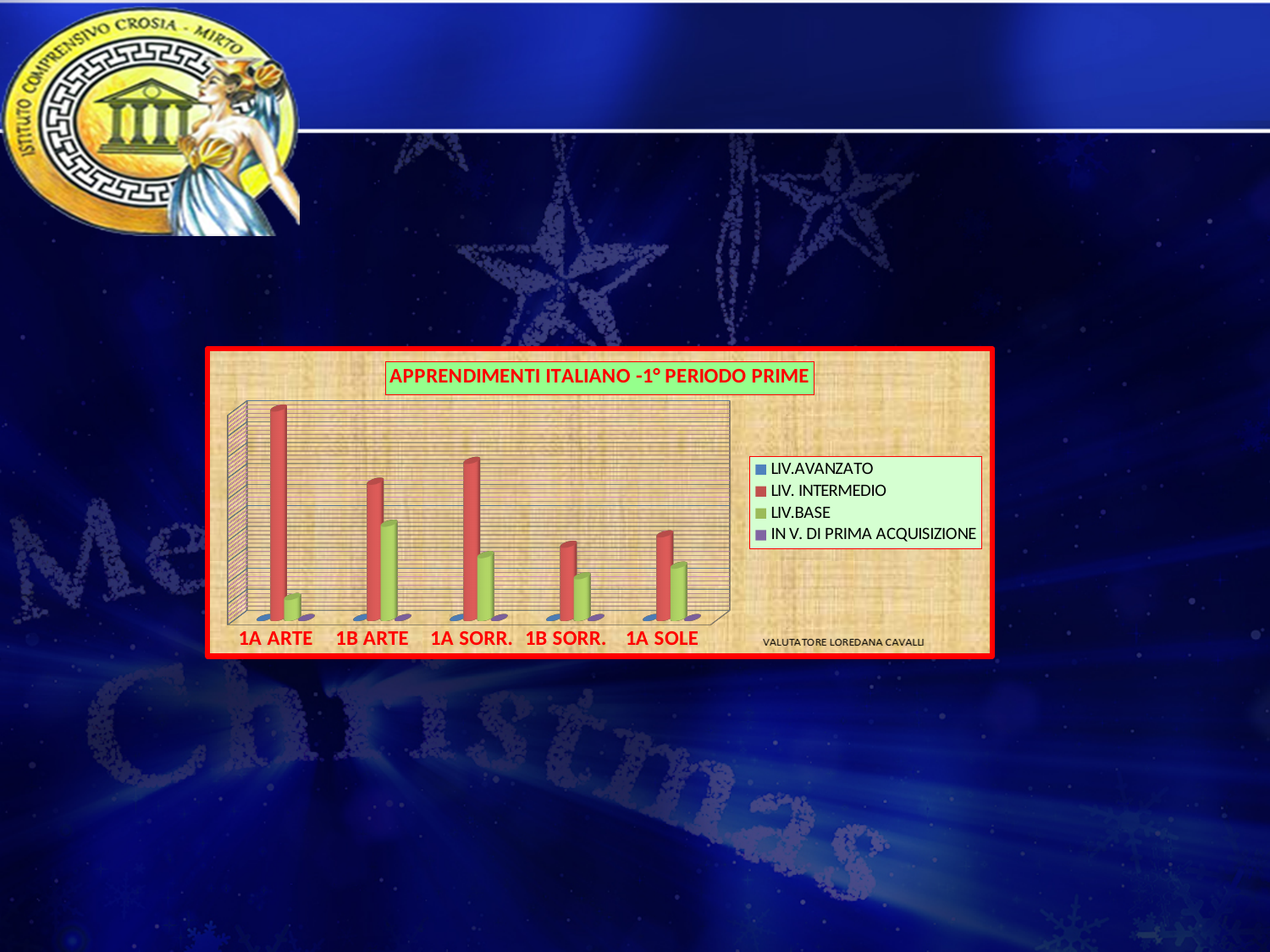
How many series does the chart legend list? 4 Is the LIV. INTERMEDIO bar larger for 1A ARTE or for 1B ARTE? 1A ARTE What kind of chart is shown on the slide? Bar chart For 1A ARTE, which is larger: the LIV. INTERMEDIO bar or the LIV.BASE bar? LIV. INTERMEDIO Is the LIV.BASE bar larger for 1B ARTE or for 1A SORR.? 1B ARTE Which class has the highest LIV.BASE bar? 1B ARTE How many categories (classes) are shown on the x axis of the chart? 5 What is the title of the chart? APPRENDIMENTI ITALIANO -1° PERIODO PRIME What colour represents LIV.BASE in the chart legend? Green Which class has the lowest LIV.BASE bar? 1A ARTE Which class has the highest LIV. INTERMEDIO bar? 1A ARTE